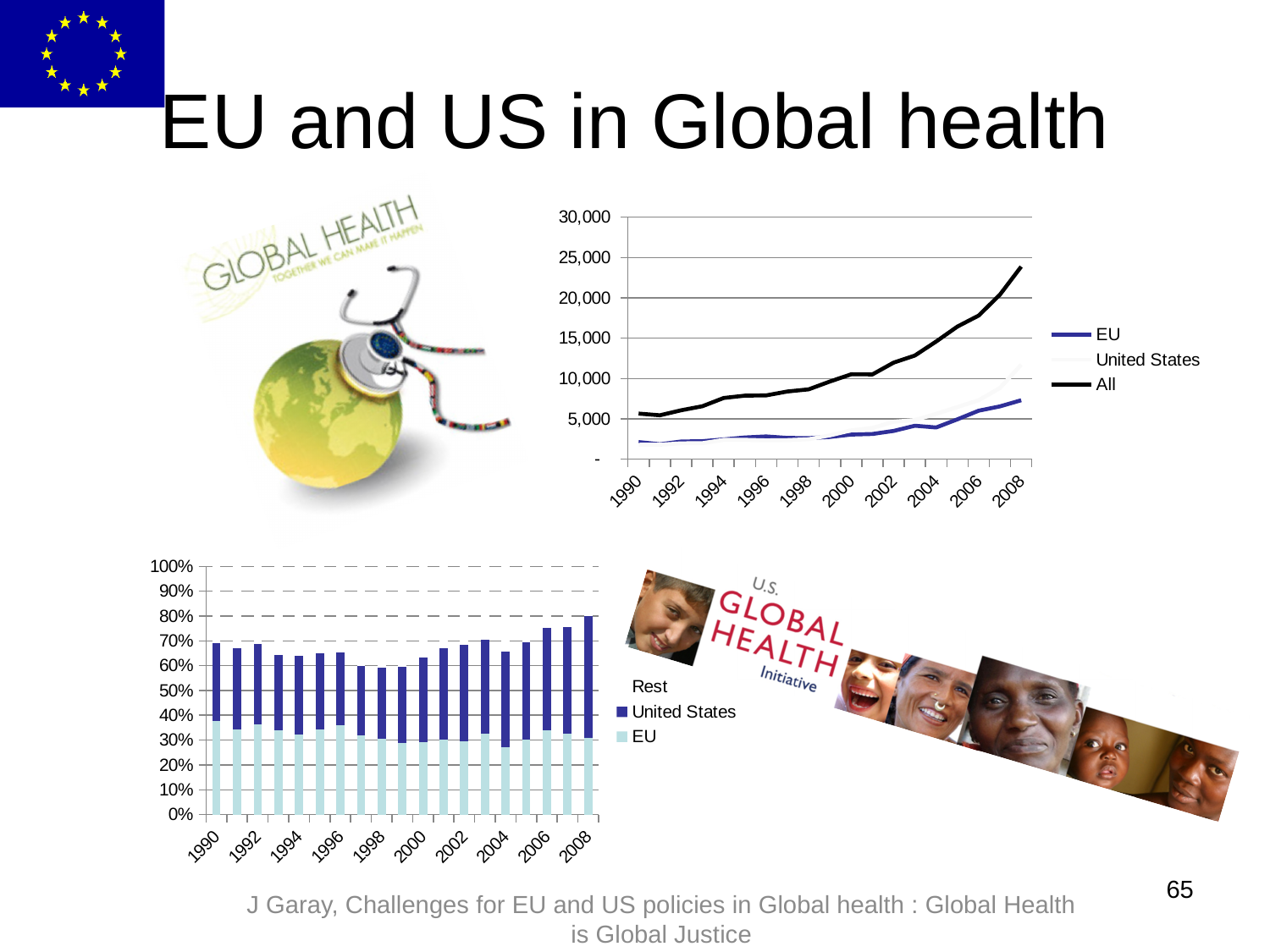
In the top-right line chart, which is larger in 2008, EU or United States? United States How many series does the legend of the top-right line chart list? 3 In the top-right line chart, is the value for All in 2008 greater or less than 20,000? greater In the top-right line chart, is the value for All in 2006 greater or less than 15,000? greater In the top-right line chart, does the All series rise or fall from 1990 to 2008? rise What kind of chart is the top-right chart? line chart What kind of chart is the bottom-left chart? bar chart In the top-right line chart, is the value for EU in 2008 greater or less than 10,000? less In the top-right line chart, which series has the highest value in 2008? All In the bottom-left bar chart, which is larger in 2008, the EU share or the United States share? United States How many entries does the legend of the bottom-left bar chart list? 3